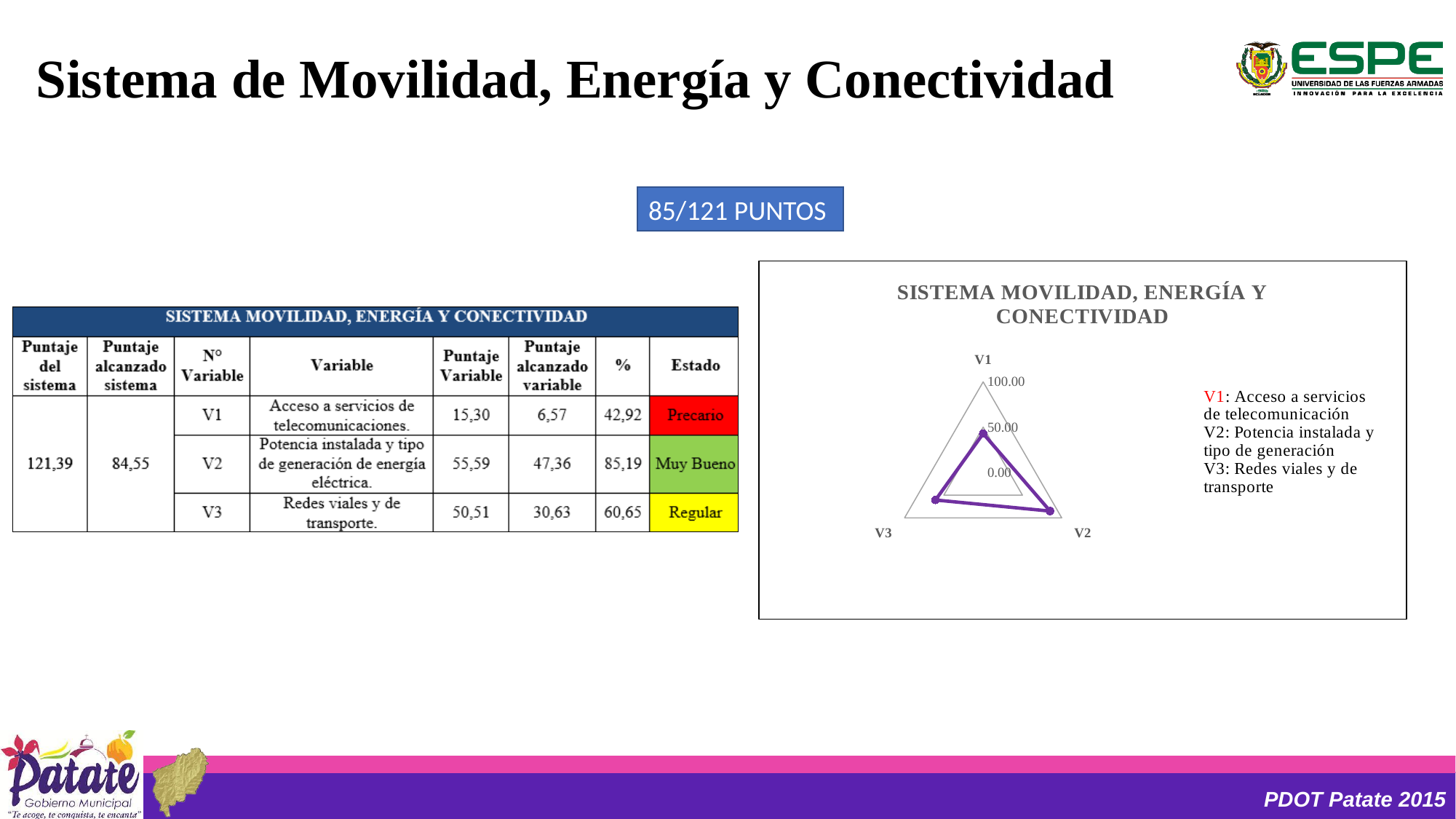
Is the value for V2 greater or less than 100.00? less What kind of chart is shown on the slide? Radar chart Which is larger on the radar chart, the value for V2 or the value for V3? V2 What is the maximum value shown on the radar chart's axis scale? 100.00 Which is larger on the radar chart, the value for V1 or the value for V2? V2 How many variables (axes) does the radar chart have? 3 Which variable has the lowest value on the radar chart? V1 What is the title of the chart? SISTEMA MOVILIDAD, ENERGÍA Y CONECTIVIDAD Which variable has the highest value on the radar chart? V2 Is the value for V2 greater or less than 50.00? greater Is the value for V3 greater or less than 50.00? greater